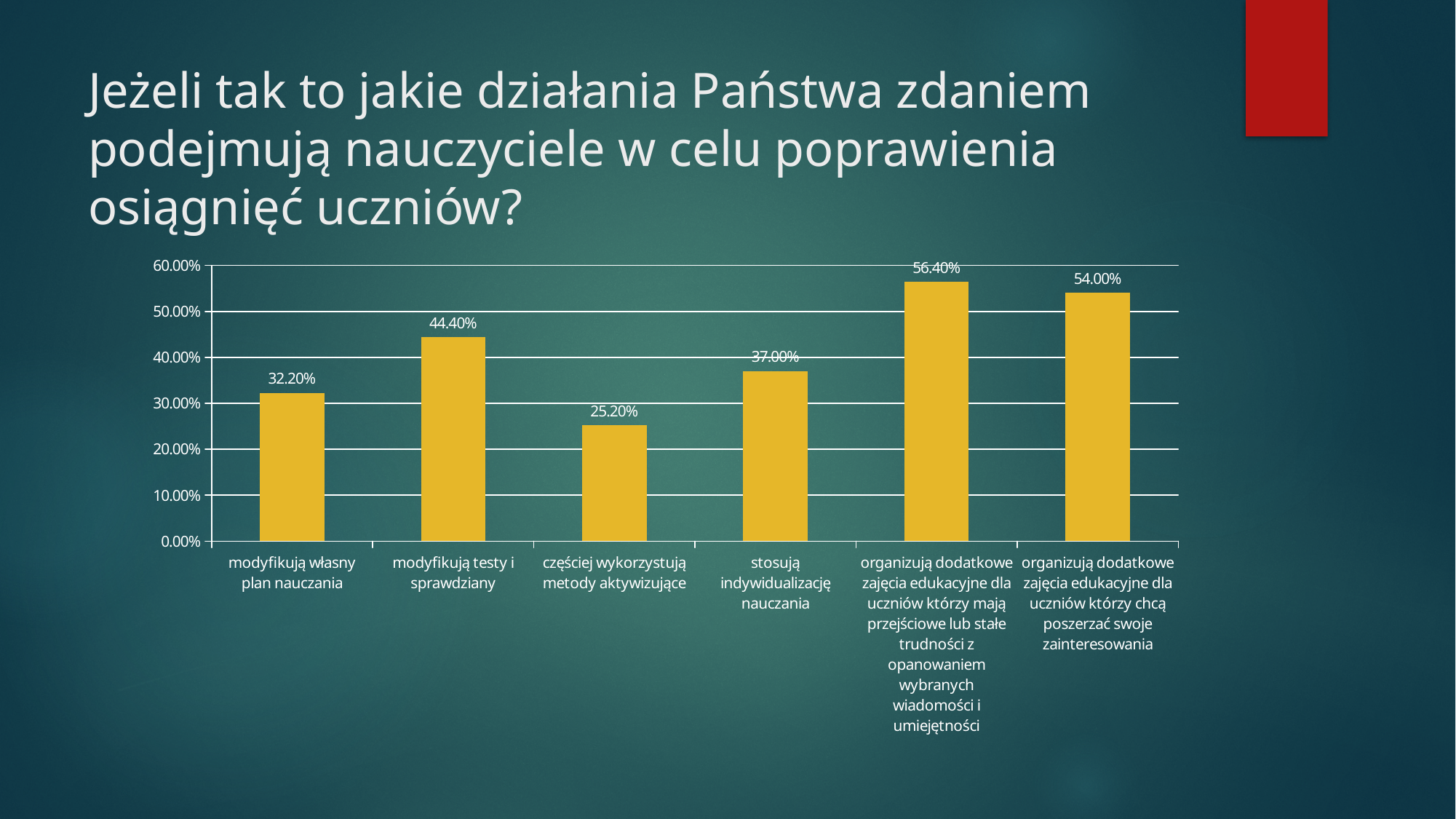
Which category has the highest value? organizują dodatkowe zajęcia edukacyjne dla uczniów którzy mają przejściowe lub stałe trudności z opanowaniem wybranych wiadomości i umiejętności What is the value for "stosują indywidualizację nauczania"? 37.00% What colour are the bars in the chart? yellow Which category has the lowest value? częściej wykorzystują metody aktywizujące How many categories are shown in the chart? 6 What kind of chart is shown on the slide? bar chart What is the difference between the values for "modyfikują testy i sprawdziany" and "modyfikują własny plan nauczania"? 12.20% What is the value for "częściej wykorzystują metody aktywizujące"? 25.20% What is the value for "modyfikują własny plan nauczania"? 32.20% Which is larger: the value for "stosują indywidualizację nauczania" or for "modyfikują własny plan nauczania"? stosują indywidualizację nauczania What is the value for "modyfikują testy i sprawdziany"? 44.40% Is the value for "organizują dodatkowe zajęcia edukacyjne dla uczniów którzy chcą poszerzać swoje zainteresowania" greater or less than 50.00%? greater